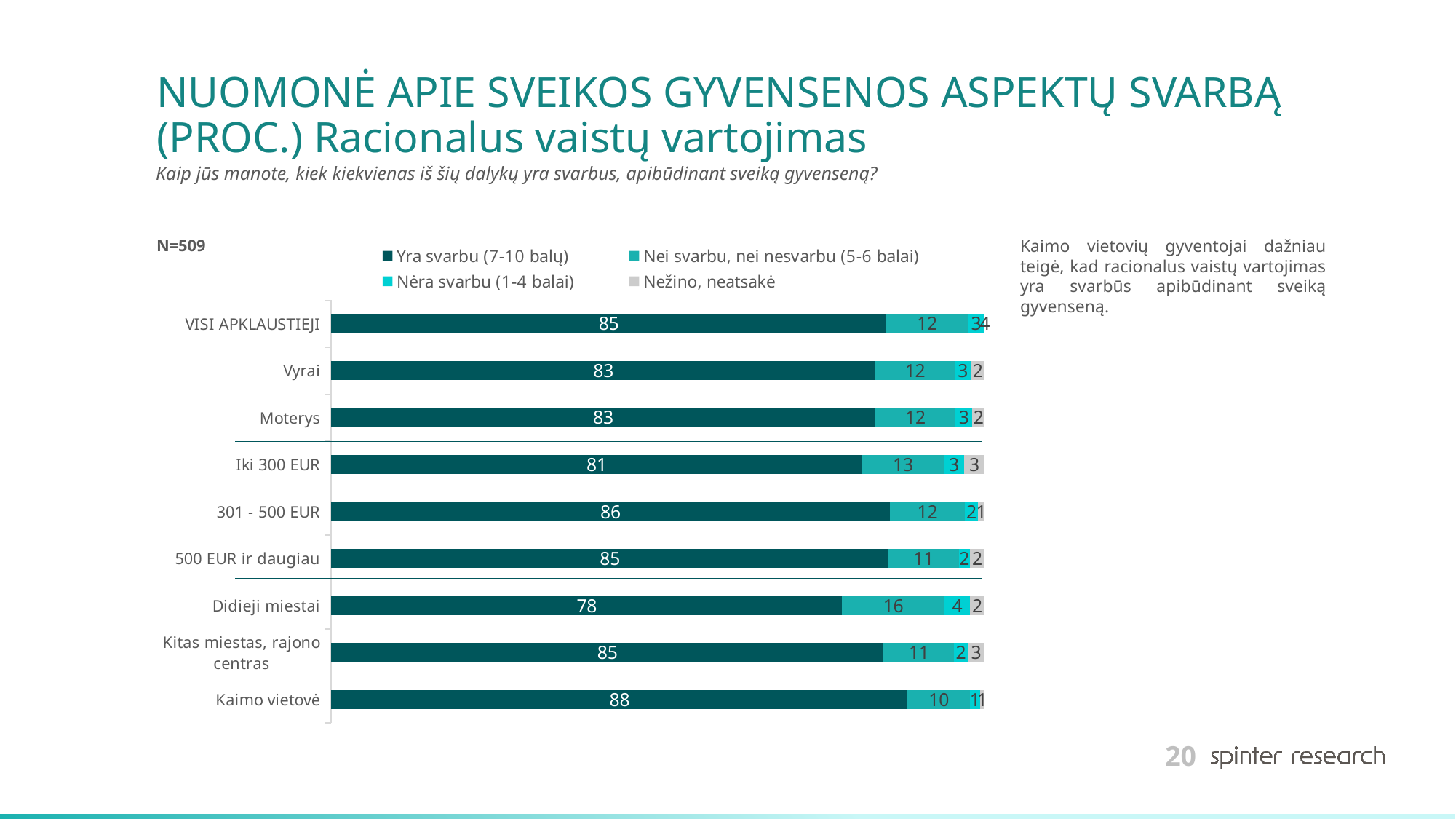
Which category has the lowest value for "Yra svarbu (7-10 balų)"? Didieji miestai Which category has the highest value for "Yra svarbu (7-10 balų)"? Kaimo vietovė What is the value of "Yra svarbu (7-10 balų)" for Kaimo vietovė? 88 Which has a larger "Yra svarbu (7-10 balų)" value, Iki 300 EUR or 301 - 500 EUR? 301 - 500 EUR How many categories are shown on the chart? 9 Which category has the highest value for "Nei svarbu, nei nesvarbu (5-6 balai)"? Didieji miestai What kind of chart is shown on the slide? Stacked bar chart What is the value of "Nei svarbu, nei nesvarbu (5-6 balai)" for Didieji miestai? 16 What is the sample size (N) stated on the slide? N=509 How many series does the legend list? 4 What is the difference between the "Yra svarbu (7-10 balų)" values for Kaimo vietovė and Didieji miestai? 10 What is the value of "Nežino, neatsakė" for Iki 300 EUR? 3